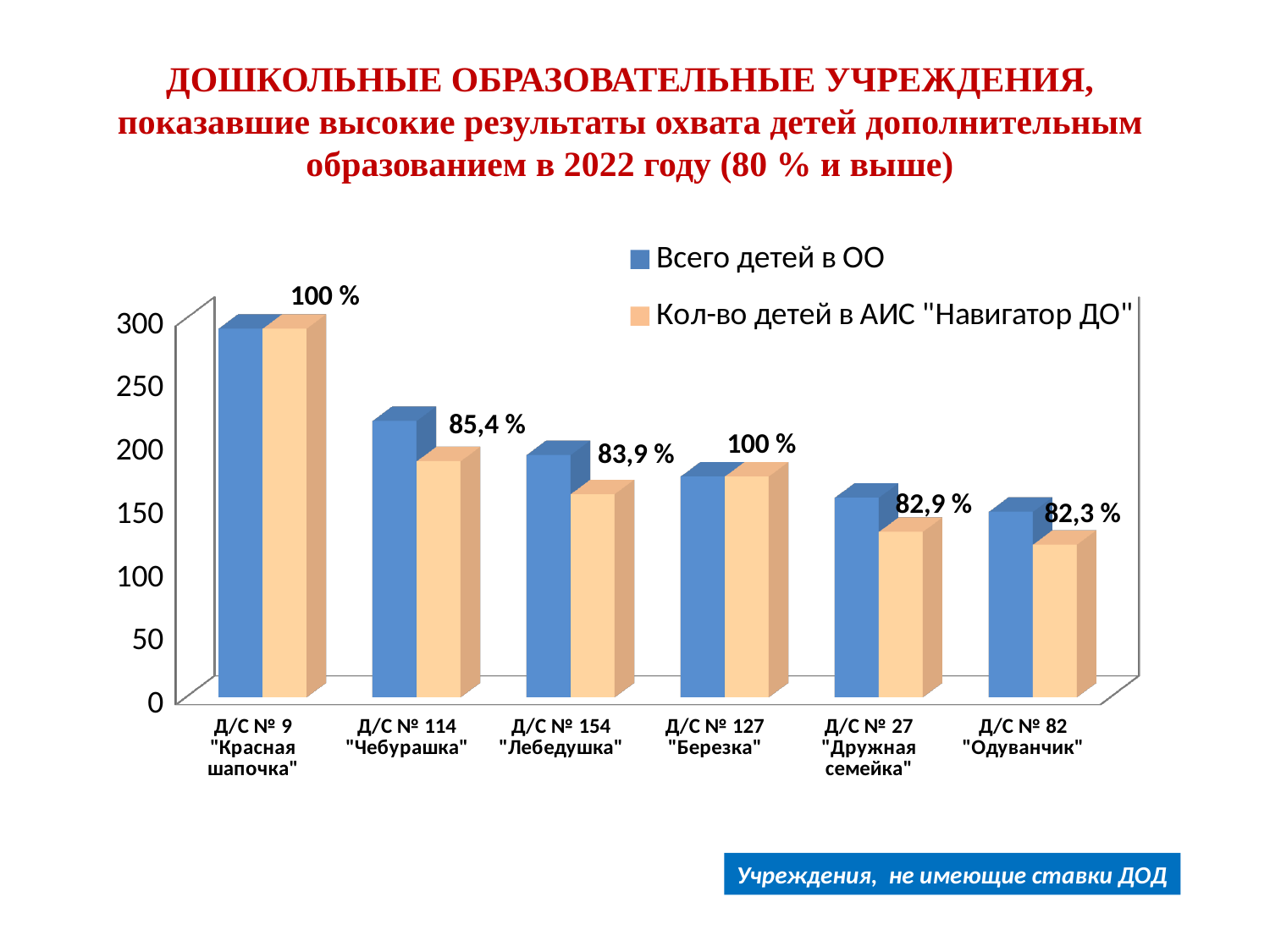
What percentage label is shown above the bars for Д/С № 114 "Чебурашка"? 85,4 % What percentage label is shown above the bars for Д/С № 82 "Одуванчик"? 82,3 % Is the "Всего детей в ОО" value for Д/С № 9 "Красная шапочка" greater or less than 250? greater Which institution has the lowest percentage label on the chart? Д/С № 82 "Одуванчик" What is the difference between the percentage labels for Д/С № 114 "Чебурашка" and Д/С № 154 "Лебедушка"? 1,5 % How many series does the legend list? 2 How many institutions (categories) are shown on the x axis? 6 Which institution has the tallest bar for "Всего детей в ОО"? Д/С № 9 "Красная шапочка" Which has a taller "Всего детей в ОО" bar: Д/С № 114 "Чебурашка" or Д/С № 154 "Лебедушка"? Д/С № 114 "Чебурашка" Do the "Всего детей в ОО" bars rise or fall from left to right along the x axis? fall What percentage label is shown above the bars for Д/С № 27 "Дружная семейка"? 82,9 % Is the "Кол-во детей в АИС "Навигатор ДО"" value for Д/С № 82 "Одуванчик" greater or less than 150? less